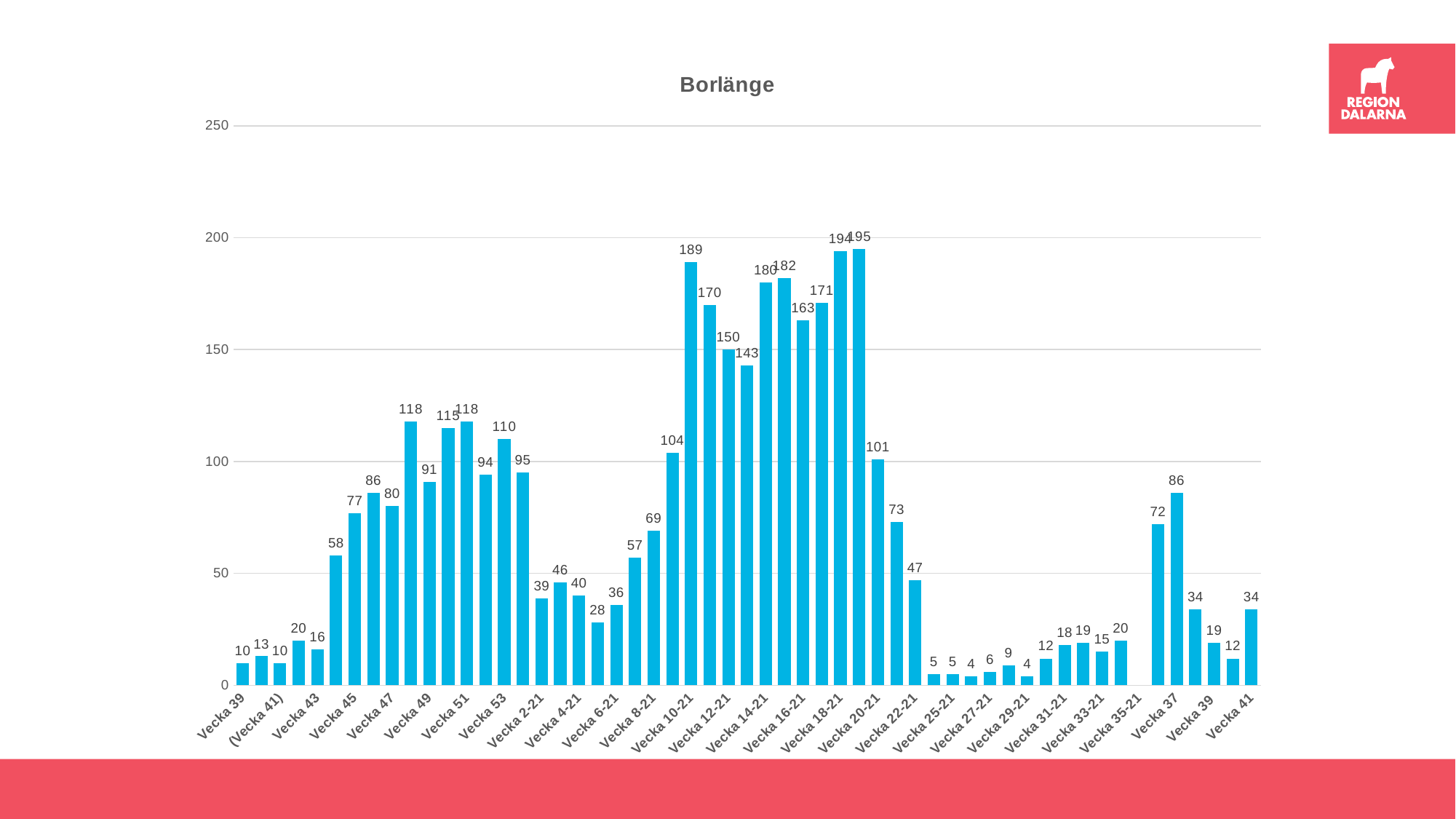
What is the difference between the values for Vecka 18-21 and Vecka 10-21? 5 What is the value for Vecka 18-21? 194 What is the value for Vecka 10-21? 189 What is the lowest value shown on the chart? 4 What is the highest value shown on the chart? 195 What is the value for Vecka 45? 77 What kind of chart is shown on the slide? bar chart What is the title of the chart? Borlänge What is the value for Vecka 41, the rightmost bar? 34 What is the value for Vecka 37? 86 Which is larger, the value for Vecka 45 or the value for Vecka 47? Vecka 47 What is the value of the leftmost bar (the first Vecka 39)? 10